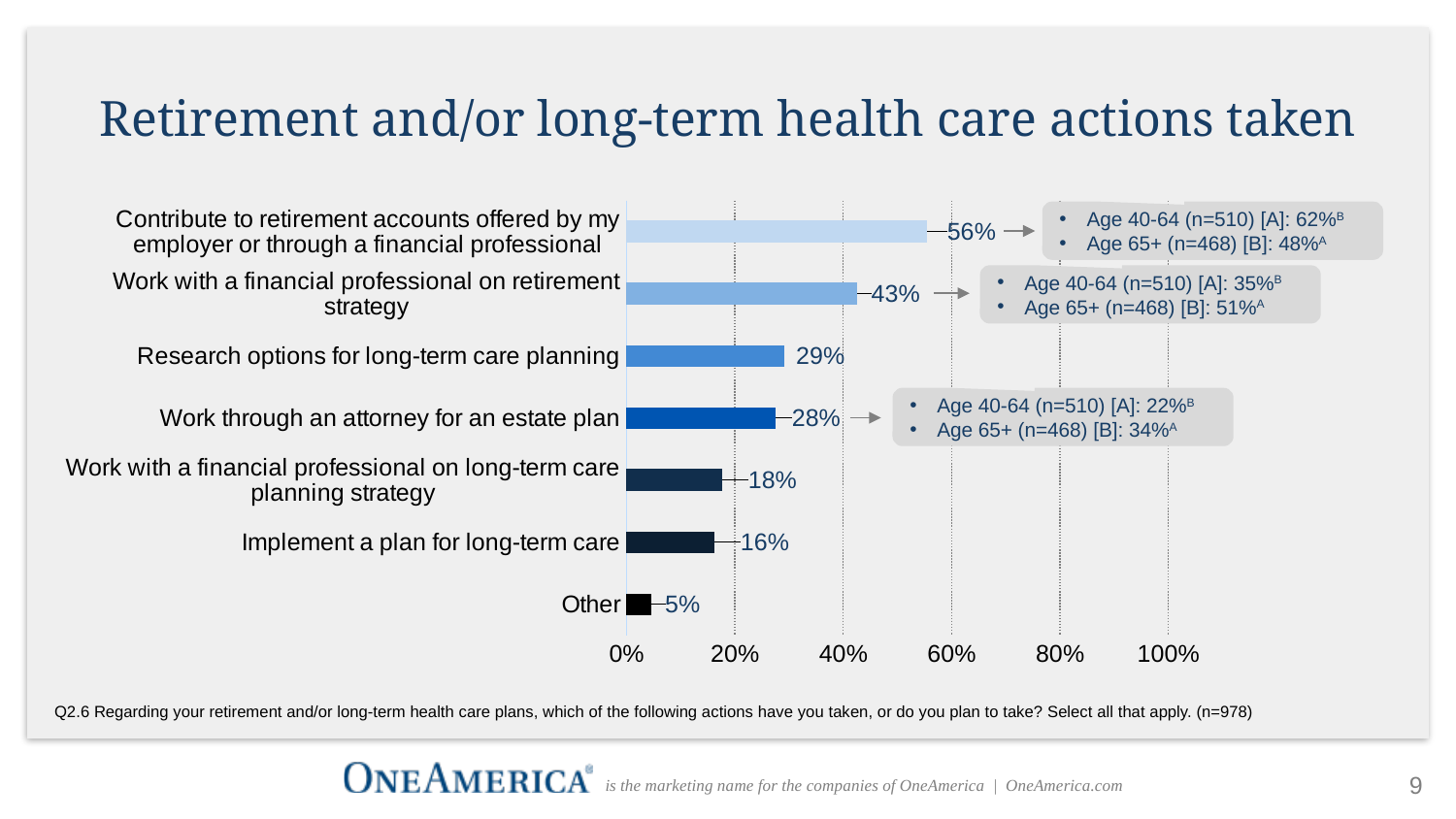
Which is larger: 'Work with a financial professional on long-term care planning strategy' or 'Implement a plan for long-term care'? Work with a financial professional on long-term care planning strategy According to the callout, what percentage of respondents aged 65+ work with a financial professional on retirement strategy? 51% Which category has the lowest value? Other What type of chart is shown on the slide? Bar chart According to the callout, what percentage of respondents aged 40-64 work through an attorney for an estate plan? 22% What is the value for 'Work with a financial professional on retirement strategy'? 43% How many categories are shown in the bar chart? 7 What is the difference between 'Research options for long-term care planning' and 'Work through an attorney for an estate plan'? 1% What is the difference between the value for contributing to retirement accounts and working with a financial professional on retirement strategy? 13% What percentage of respondents contribute to retirement accounts offered by their employer or through a financial professional? 56% What percentage of respondents implement a plan for long-term care? 16% Which action has the highest percentage? Contribute to retirement accounts offered by my employer or through a financial professional